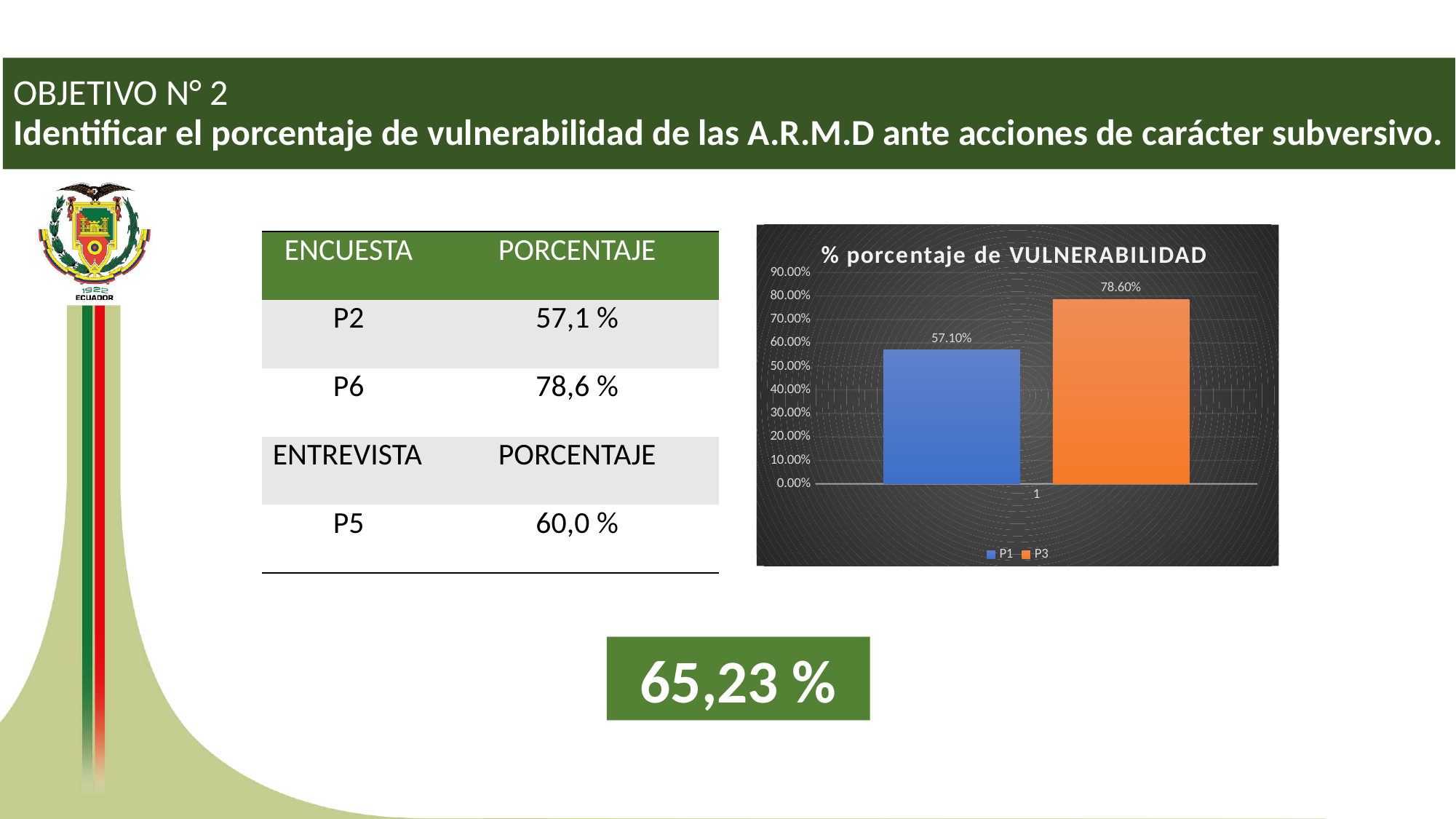
What is the value of the P1 series in the chart? 57.10% What is the title of the chart? % porcentaje de VULNERABILIDAD What is the highest value shown on the chart's vertical axis? 90.00% Which series has the lowest value in the chart? P1 Is the value for P3 greater or less than 70.00%? greater What colour is the bar for the P3 series? Orange What is the value of the P3 series in the chart? 78.60% Which series has the higher value in the chart, P1 or P3? P3 What is the difference between the P3 and P1 values in the chart? 21.50% Is the value for P1 greater or less than 60.00%? less How many series does the chart legend list? 2 What kind of chart is shown on the slide? Bar chart